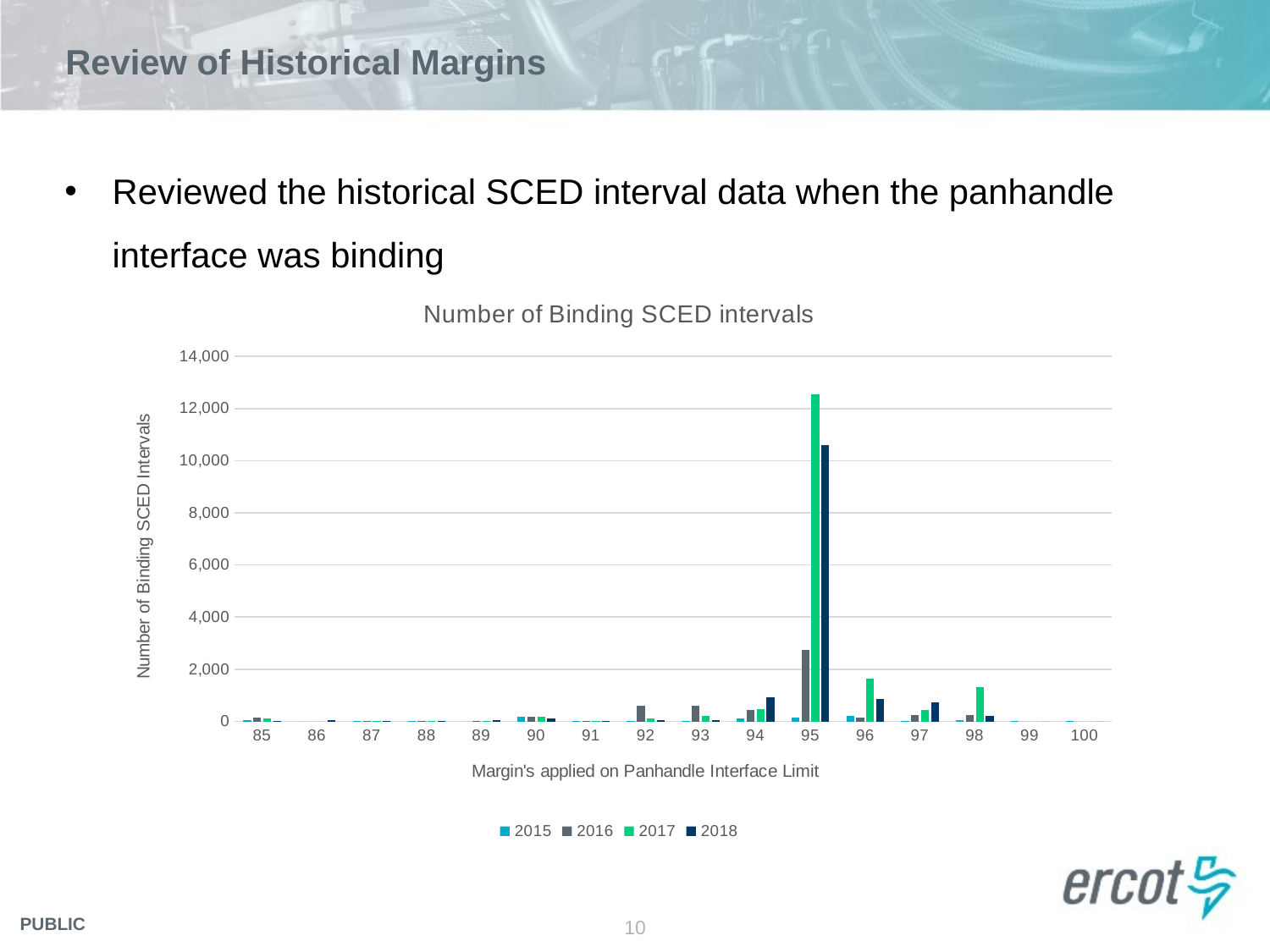
What type of chart is shown on the slide? bar chart How many margin categories are shown along the x axis? 16 Is the 2018 value at margin 95 greater or less than 10,000? greater What is the title of the chart? Number of Binding SCED intervals Is the 2017 value at margin 95 greater or less than 12,000? greater At which margin value does the 2017 series reach its highest number of binding SCED intervals? 95 At margin 95, which series has the larger value, 2017 or 2018? 2017 How many series does the legend list? 4 Is the 2017 value at margin 96 greater or less than 2,000? less At which margin value does the 2018 series reach its highest number of binding SCED intervals? 95 What is the label of the x axis? Margin's applied on Panhandle Interface Limit